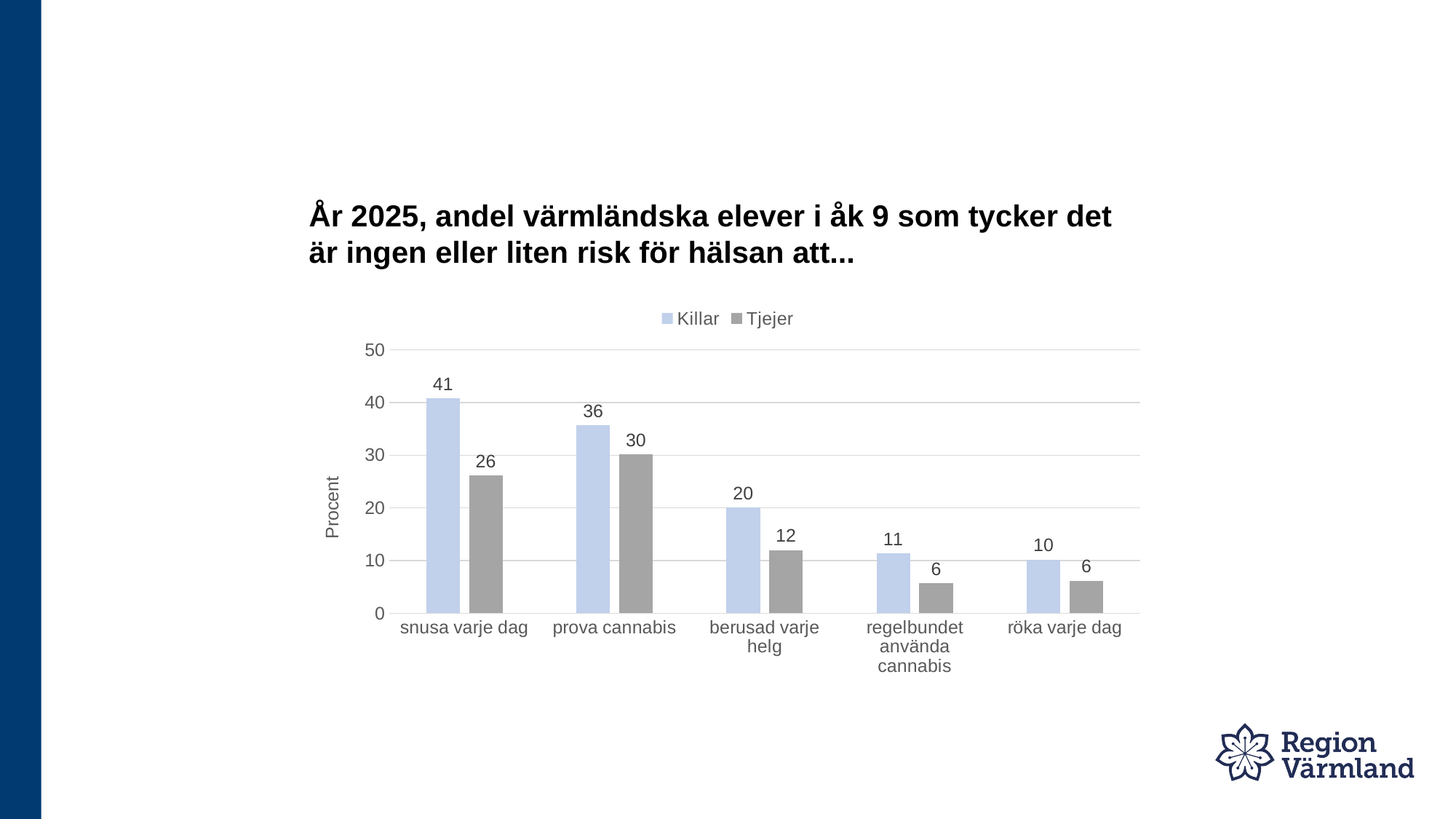
What is the difference between Killar and Tjejer for 'snusa varje dag'? 15 What kind of chart is shown on the slide? bar chart Which category has the highest value for Tjejer? prova cannabis Which category has the highest value for Killar? snusa varje dag Which is larger for 'prova cannabis', Killar or Tjejer? Killar What is the value for Tjejer for 'prova cannabis'? 30 How many categories are shown on the x axis? 5 What is the value for Tjejer for 'berusad varje helg'? 12 What is the value for Killar for 'snusa varje dag'? 41 How many series does the legend list? 2 What is the difference between Killar and Tjejer for 'berusad varje helg'? 8 Which category has the lowest value for Killar? röka varje dag